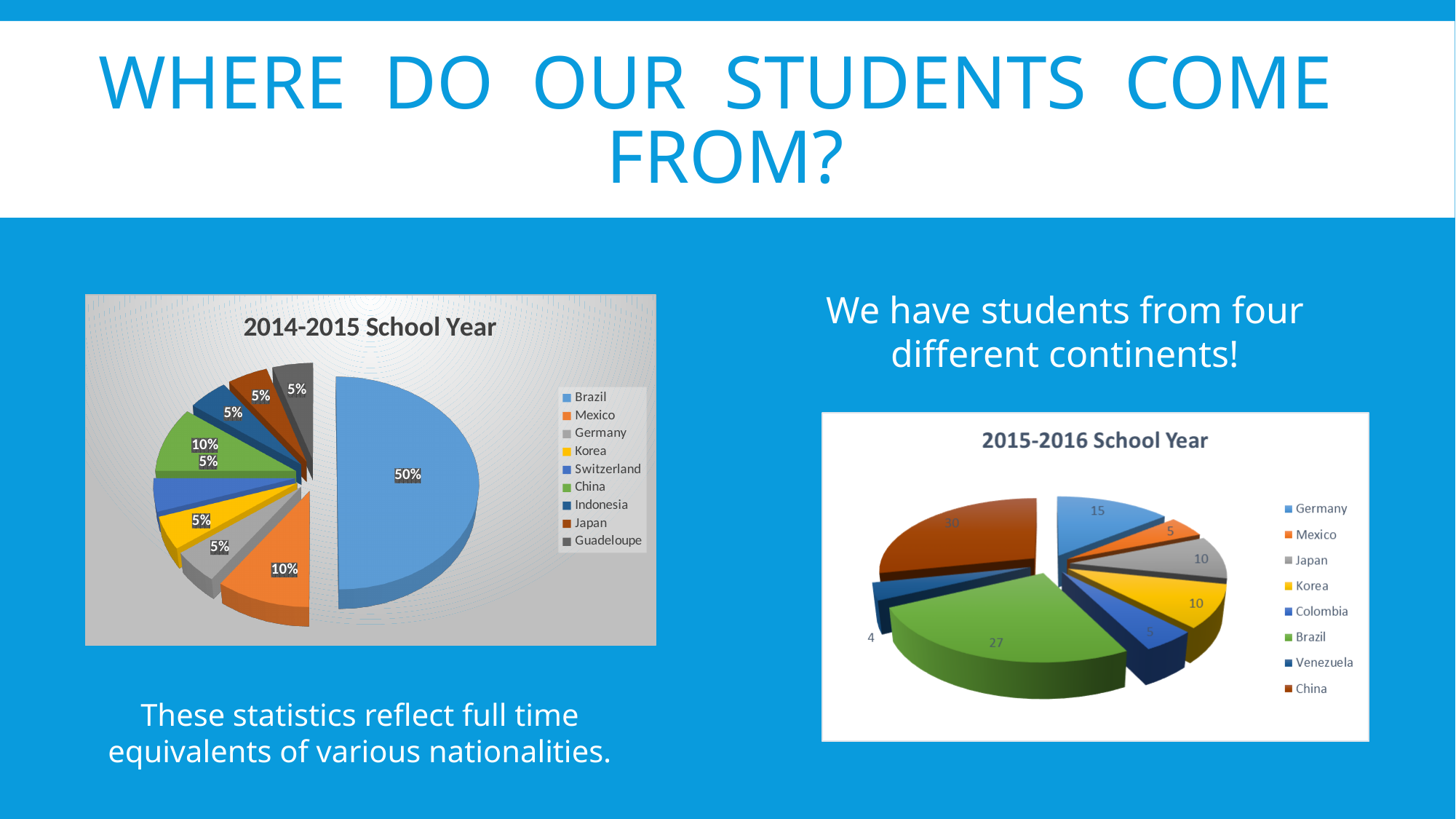
What kind of chart is the 2014-2015 School Year chart? Pie chart In the 2015-2016 School Year chart, what is the value for China? 30 In the 2015-2016 School Year chart, what is the difference between the values for China and Brazil? 3 In the 2014-2015 School Year chart, what share of students is from Mexico? 10% In the 2014-2015 School Year chart, which country has the largest slice? Brazil In the 2015-2016 School Year chart, which country has the smallest value? Venezuela In the 2015-2016 School Year chart, which is larger, the value for Germany or the value for Japan? Germany In the 2014-2015 School Year chart, what share of students is from Brazil? 50% How many countries are listed in the legend of the 2015-2016 School Year chart? 8 How many countries are listed in the legend of the 2014-2015 School Year chart? 9 In the 2015-2016 School Year chart, what is the value for Brazil? 27 In the 2015-2016 School Year chart, what is the value for Germany? 15